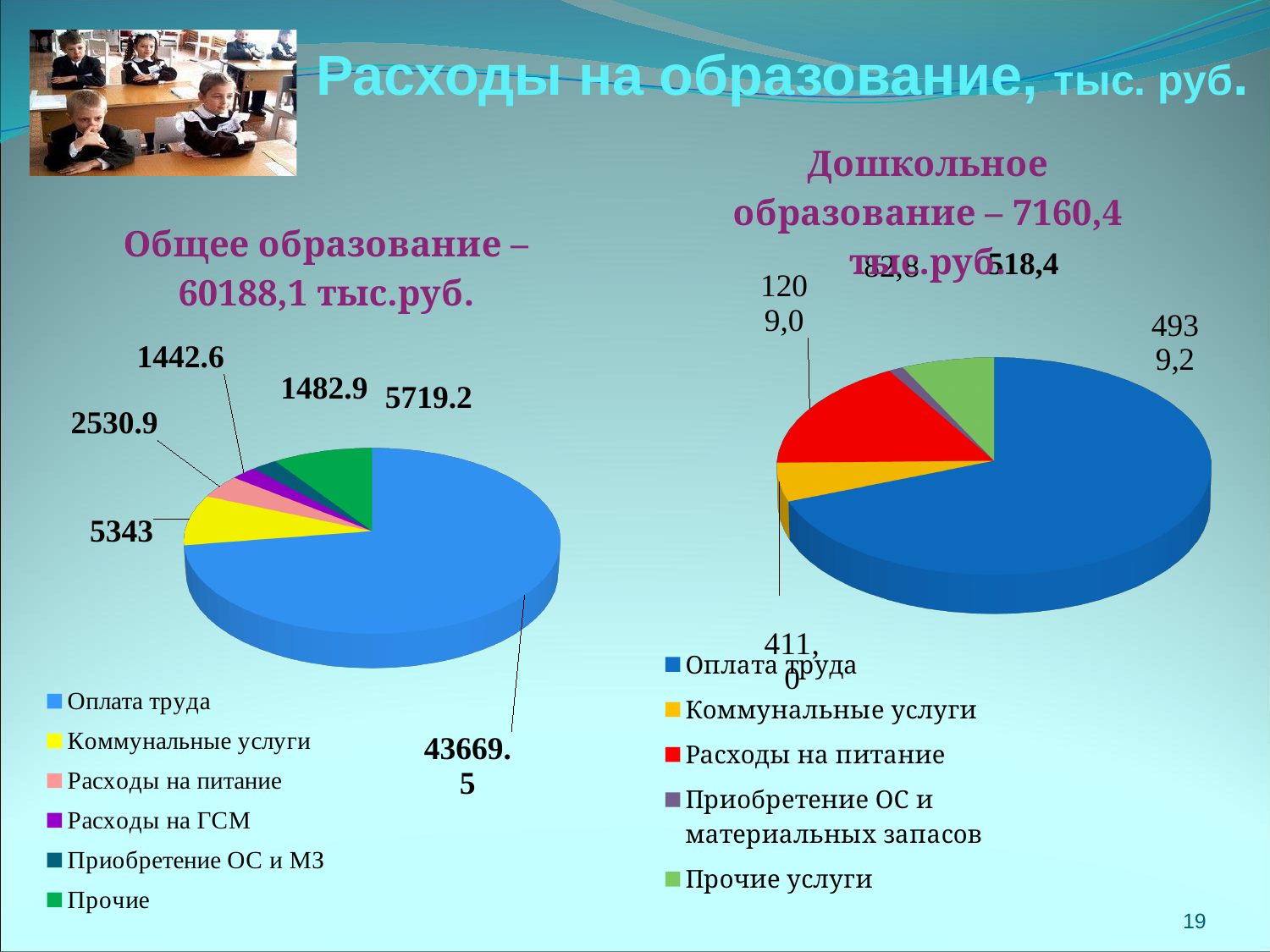
In the left chart 'Общее образование', what is the value for 'Коммунальные услуги'? 5343 What type of chart is used on the left for 'Общее образование'? pie chart In the left chart 'Общее образование', which category has the largest value? Оплата труда In the left chart 'Общее образование', which is larger: 'Расходы на питание' or 'Приобретение ОС и МЗ'? Расходы на питание How many categories does the legend of the right chart 'Дошкольное образование' list? 5 In the left chart 'Общее образование', what is the value for 'Прочие'? 5719.2 In the left chart 'Общее образование', which category has the smallest value? Расходы на ГСМ In the left chart 'Общее образование', what is the value for 'Оплата труда'? 43669.5 In the right chart 'Дошкольное образование', what is the value for 'Прочие услуги'? 518,4 How many categories does the legend of the left chart 'Общее образование' list? 6 In the left chart 'Общее образование', what is the difference between 'Прочие' and 'Коммунальные услуги'? 376.2 In the right chart 'Дошкольное образование', which category has the largest value? Оплата труда